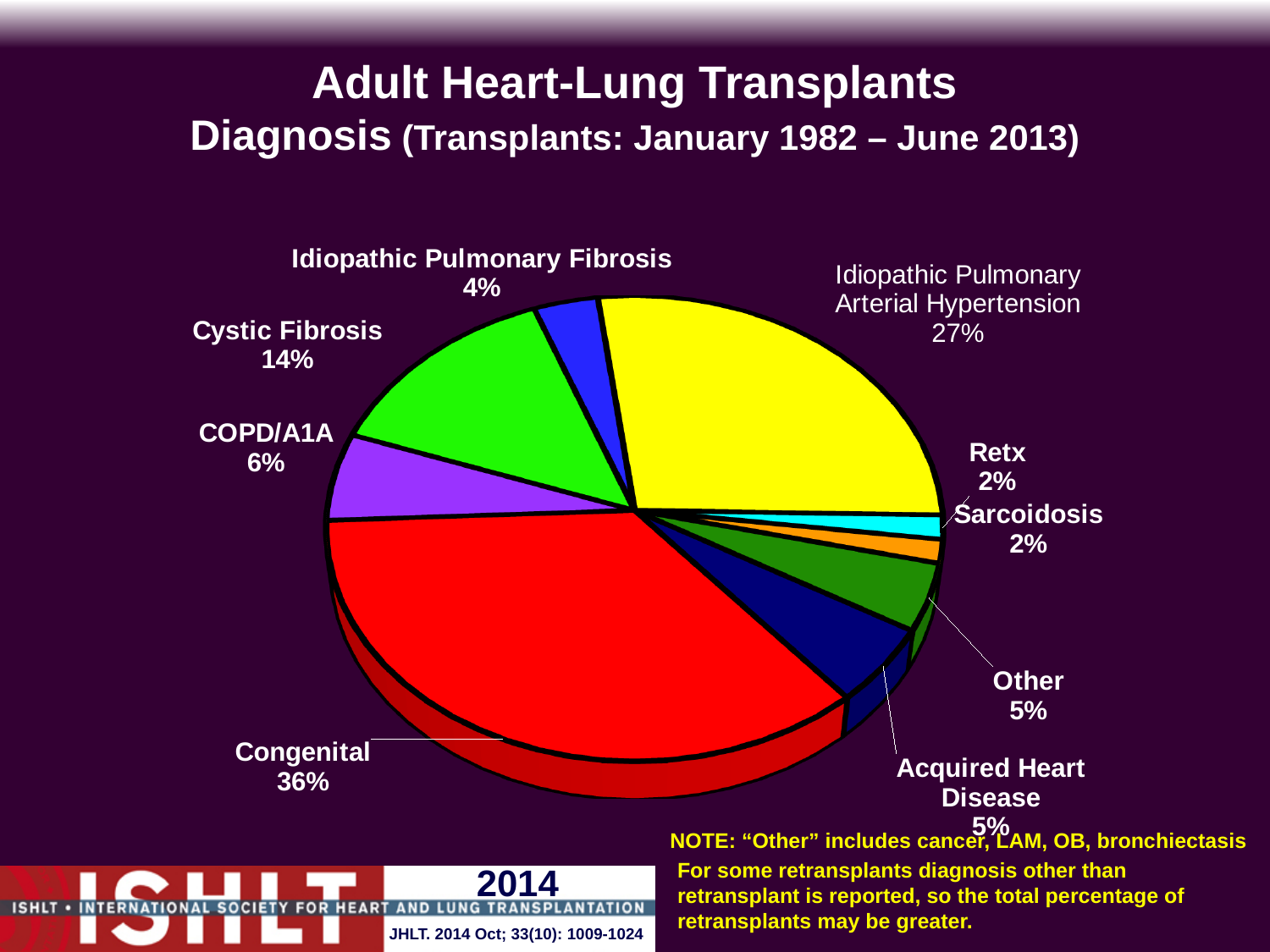
What percentage is shown for Idiopathic Pulmonary Fibrosis? 4% What percentage is shown for COPD/A1A? 6% How many diagnosis categories are shown in the pie chart? 9 What share of the pie is Idiopathic Pulmonary Arterial Hypertension? 27% Which diagnosis has the largest share of the pie? Congenital What type of chart is shown on the slide? Pie chart What percentage of adult heart-lung transplants had a diagnosis of Congenital? 36% What is the difference in percentage points between Congenital and Idiopathic Pulmonary Arterial Hypertension? 9 What percentage is shown for Cystic Fibrosis? 14% Which is larger, the share for Cystic Fibrosis or the share for COPD/A1A? Cystic Fibrosis What colour is the Congenital slice of the pie? Red What percentage is shown for Acquired Heart Disease? 5%